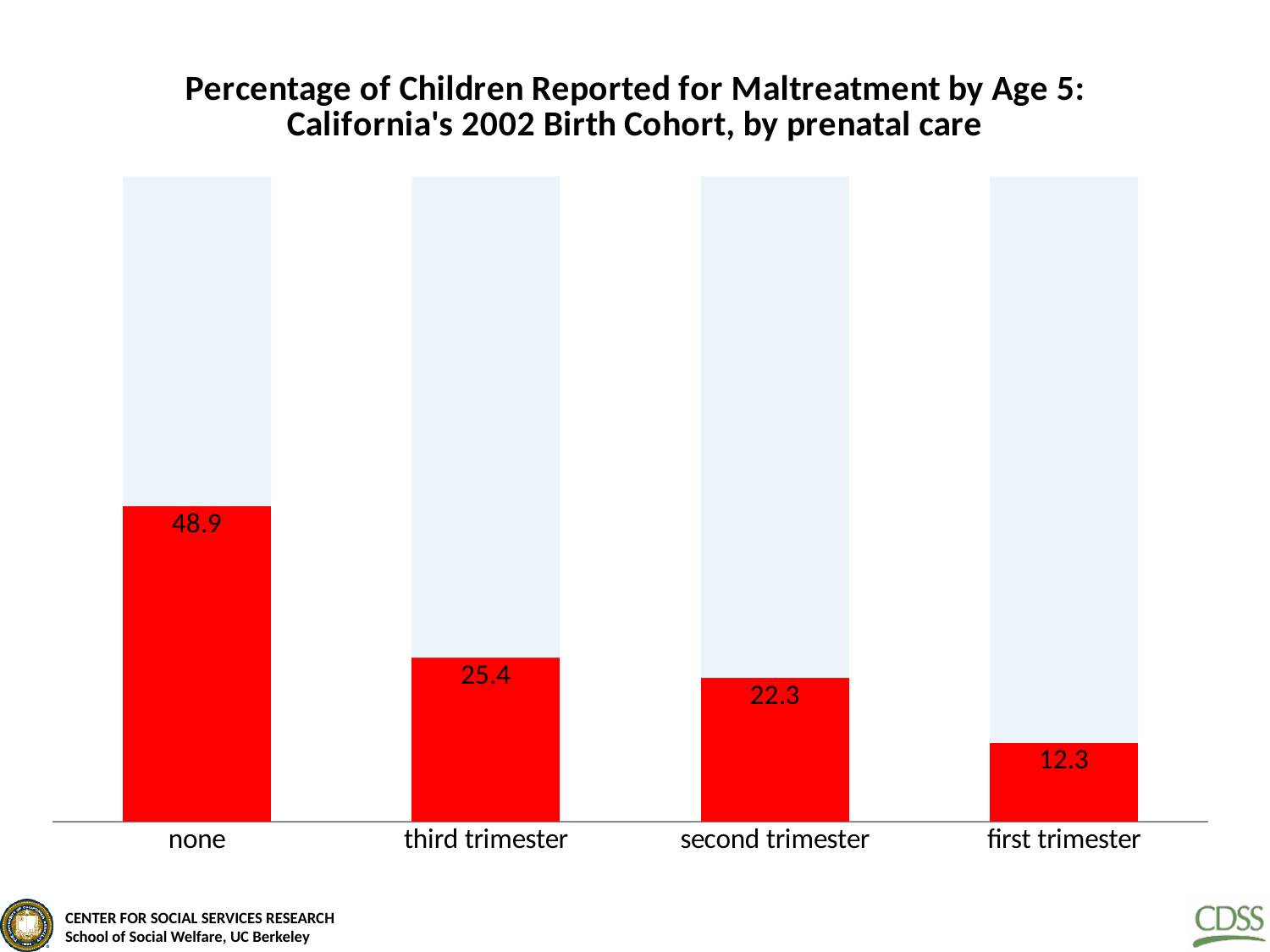
What is the difference between the values for third trimester and second trimester? 3.1 Which is larger, the value for third trimester or the value for second trimester? third trimester Do the values rise or fall moving from left to right across the categories? fall What kind of chart is shown on the slide? bar chart What percentage of children with no prenatal care were reported for maltreatment by age 5? 48.9 What is the value shown for the third trimester category? 25.4 Which prenatal care category has the lowest percentage of children reported for maltreatment? first trimester What is the value shown for the second trimester category? 22.3 What is the value shown for the first trimester category? 12.3 What is the difference between the values for none and first trimester? 36.6 Which prenatal care category has the highest percentage of children reported for maltreatment? none How many prenatal care categories are shown on the chart? 4